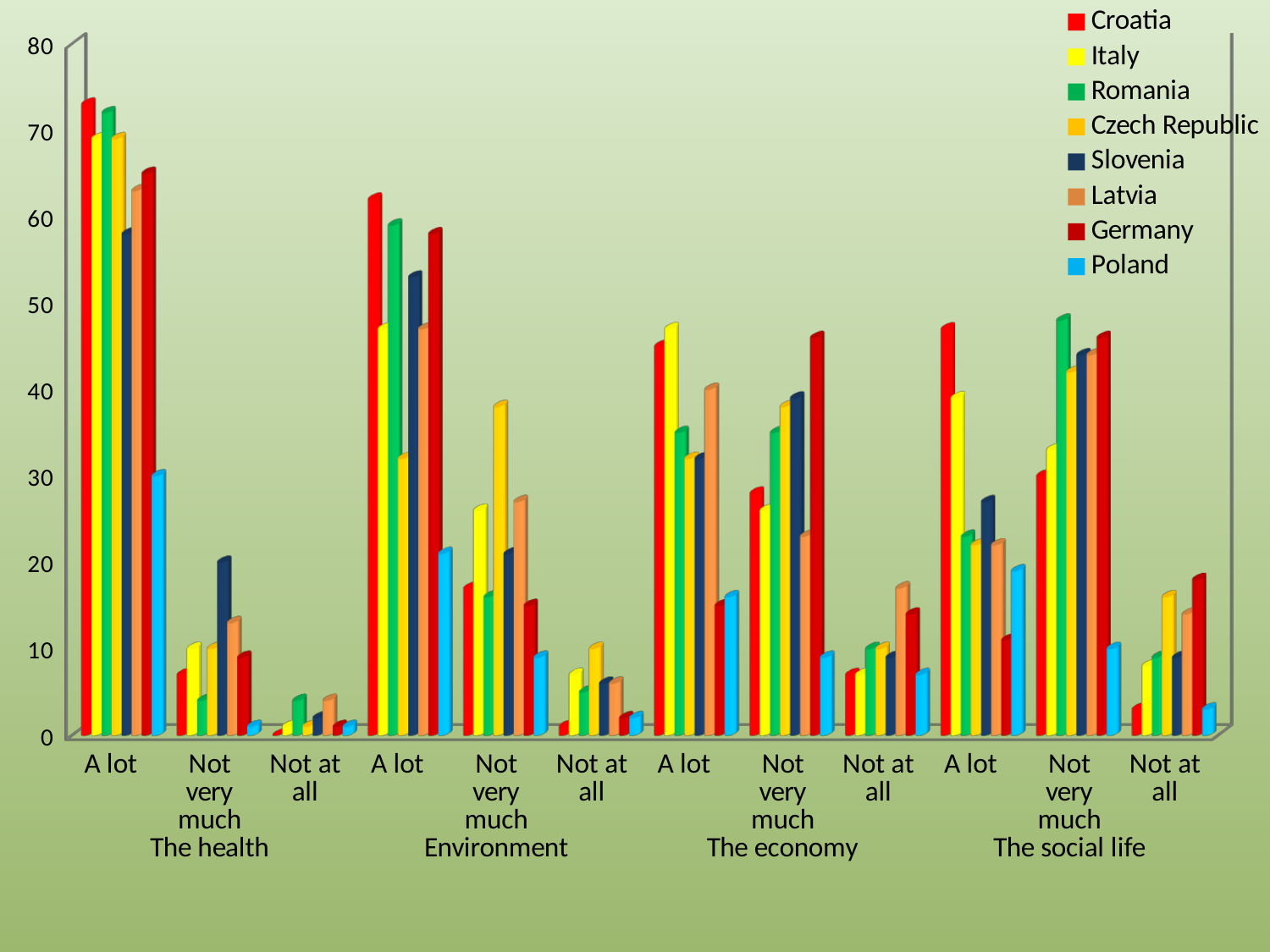
Is the value for Czech Republic under 'Not very much' in the Environment group greater or less than 30? greater Under 'Not very much' in The social life group, which is larger: the value for Romania or the value for Croatia? Romania Is the value for Germany under 'Not very much' in The economy group greater or less than 40? greater What kind of chart is shown on the slide? Bar chart Is the value for Poland under 'A lot' in the Environment group greater or less than 30? less Which country has the lowest value under 'A lot' in The health group? Poland How many series does the legend list? 8 Which country has the highest value under 'Not very much' in the Environment group? Czech Republic Which country is listed first in the legend? Croatia How many topic groups (such as The health, Environment) are shown along the x axis? 4 What colour represents Poland in the chart? Light blue